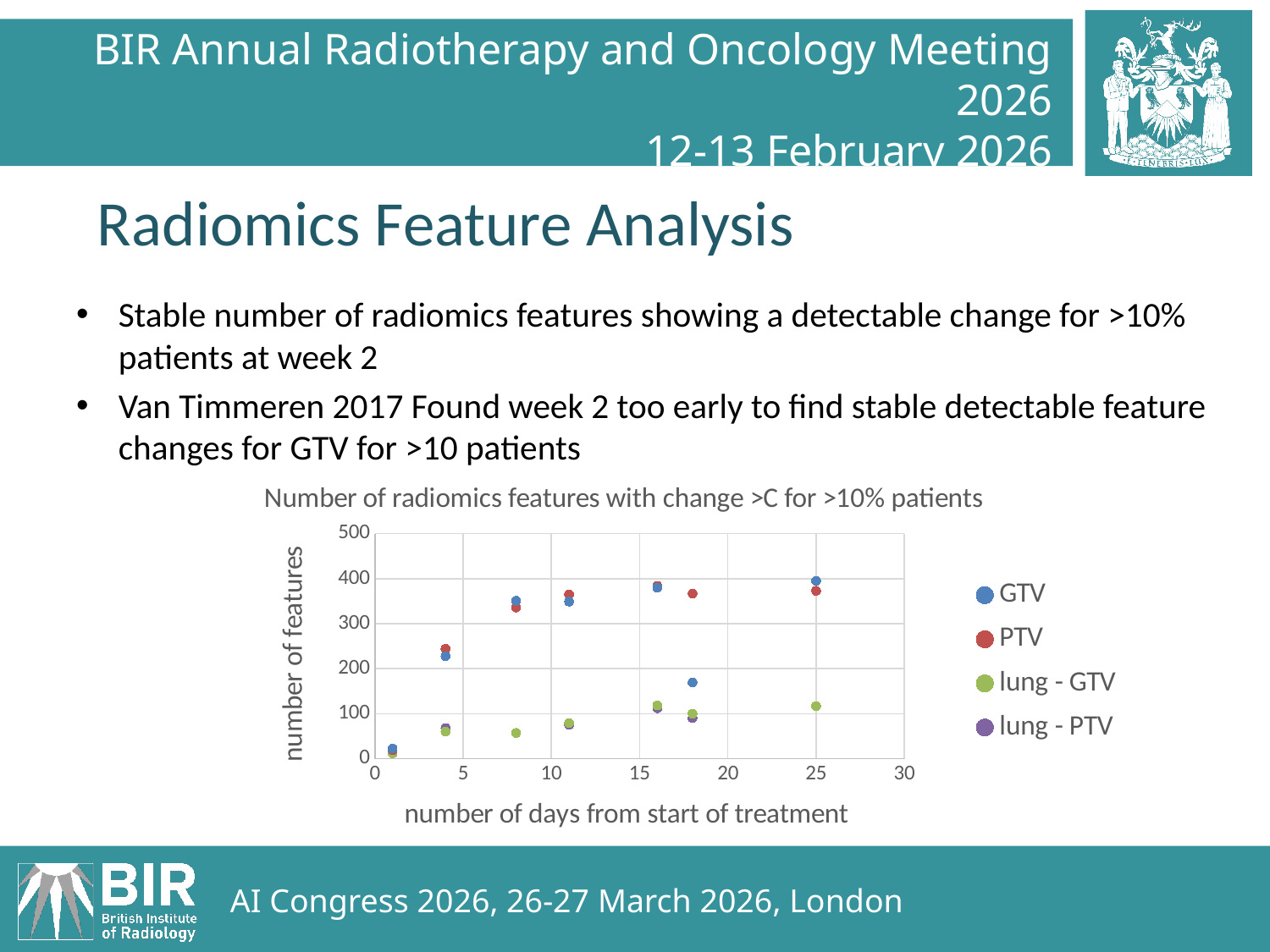
At day 25, which series has the larger value, GTV or lung - GTV? GTV Which series has the lowest value at day 18? lung - PTV How many series does the chart legend list? 4 Is the GTV value at day 25 greater or less than 300? greater Is the GTV value at day 18 greater or less than 100? greater What kind of chart is shown on the slide? scatter chart What is the label of the x axis of the chart? number of days from start of treatment Do the PTV values generally rise or fall as the number of days from start of treatment increases? rise Is the PTV value at day 4 greater or less than 300? less At day 18, which series has the larger value, GTV or PTV? PTV What is the title of the chart? Number of radiomics features with change >C for >10% patients